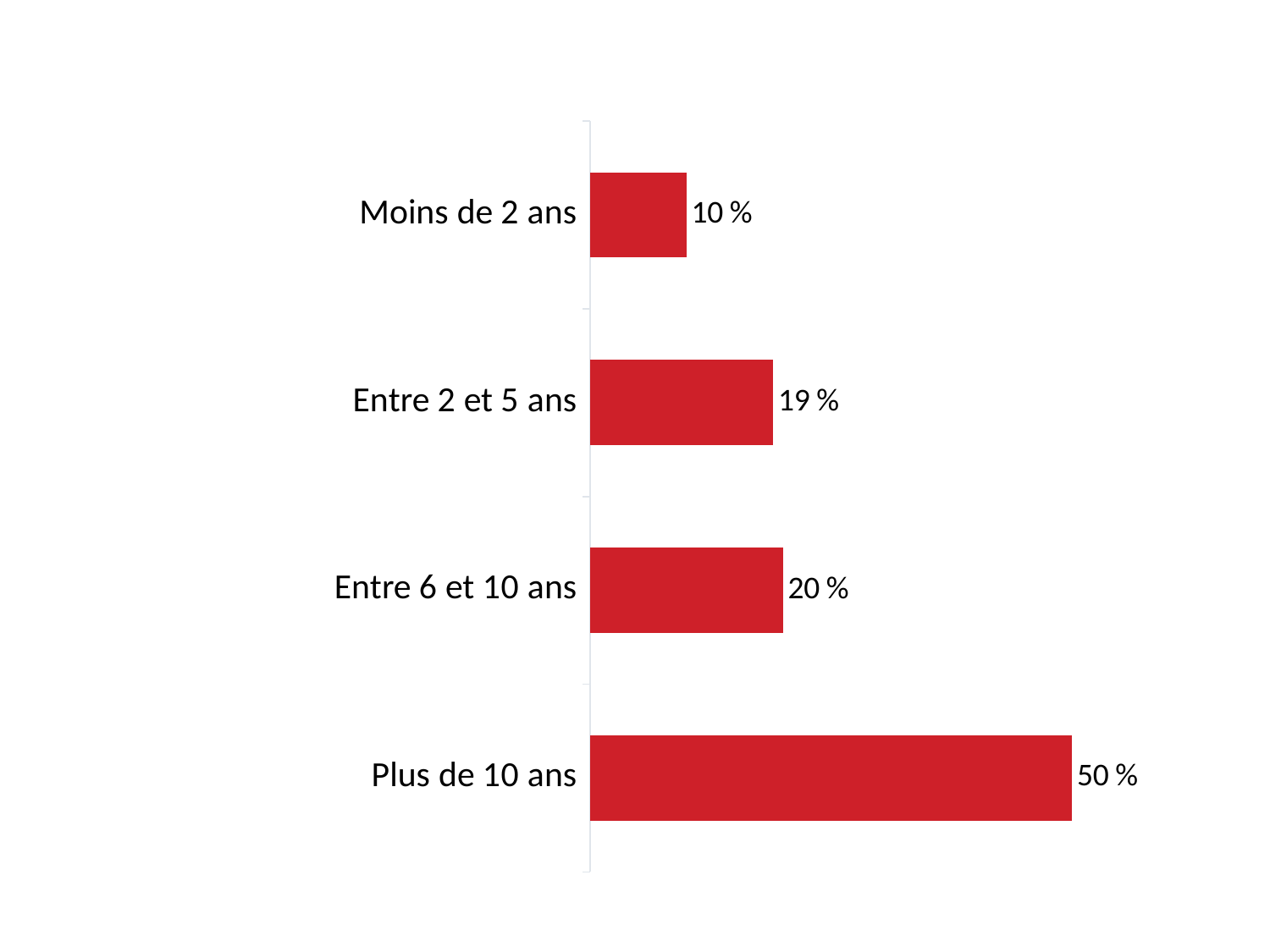
What is the value for "Entre 2 et 5 ans"? 19 % Which category has the highest value? Plus de 10 ans Which category has the lowest value? Moins de 2 ans What is the value for "Entre 6 et 10 ans"? 20 % What colour are the bars in the chart? Red How many categories are shown in the chart? 4 What is the value for "Plus de 10 ans"? 50 % What is the value for "Moins de 2 ans"? 10 % Which is larger, the value for "Plus de 10 ans" or the value for "Entre 6 et 10 ans"? Plus de 10 ans What is the difference between the values for "Entre 6 et 10 ans" and "Entre 2 et 5 ans"? 1 % What is the difference between the values for "Plus de 10 ans" and "Moins de 2 ans"? 40 % What kind of chart is shown on the slide? Bar chart